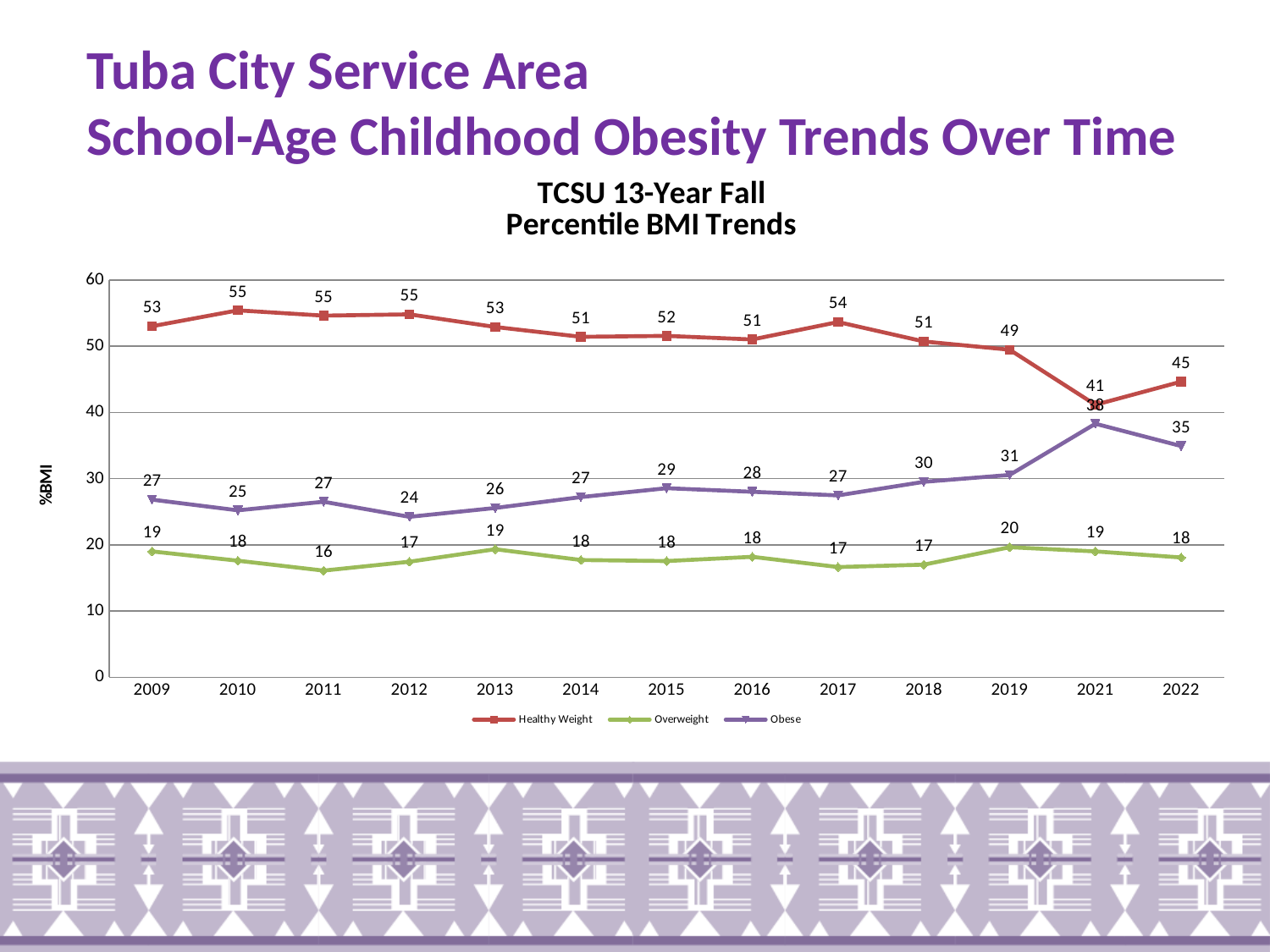
What is the Healthy Weight value for 2022? 45 Does the Healthy Weight series overall rise or fall from 2009 to 2022? fall In 2022, which is larger: the Obese value or the Overweight value? Obese In which year is the Obese series at its highest? 2021 What is the Overweight value for 2011? 16 In which year is the Healthy Weight series at its lowest? 2021 What is the difference between the Healthy Weight value in 2009 and in 2022? 8 How many series does the legend list? 3 How many years are plotted along the x axis? 13 What is the Obese value for 2019? 31 What kind of chart is shown on the slide? line chart What is the title of the chart? TCSU 13-Year Fall Percentile BMI Trends